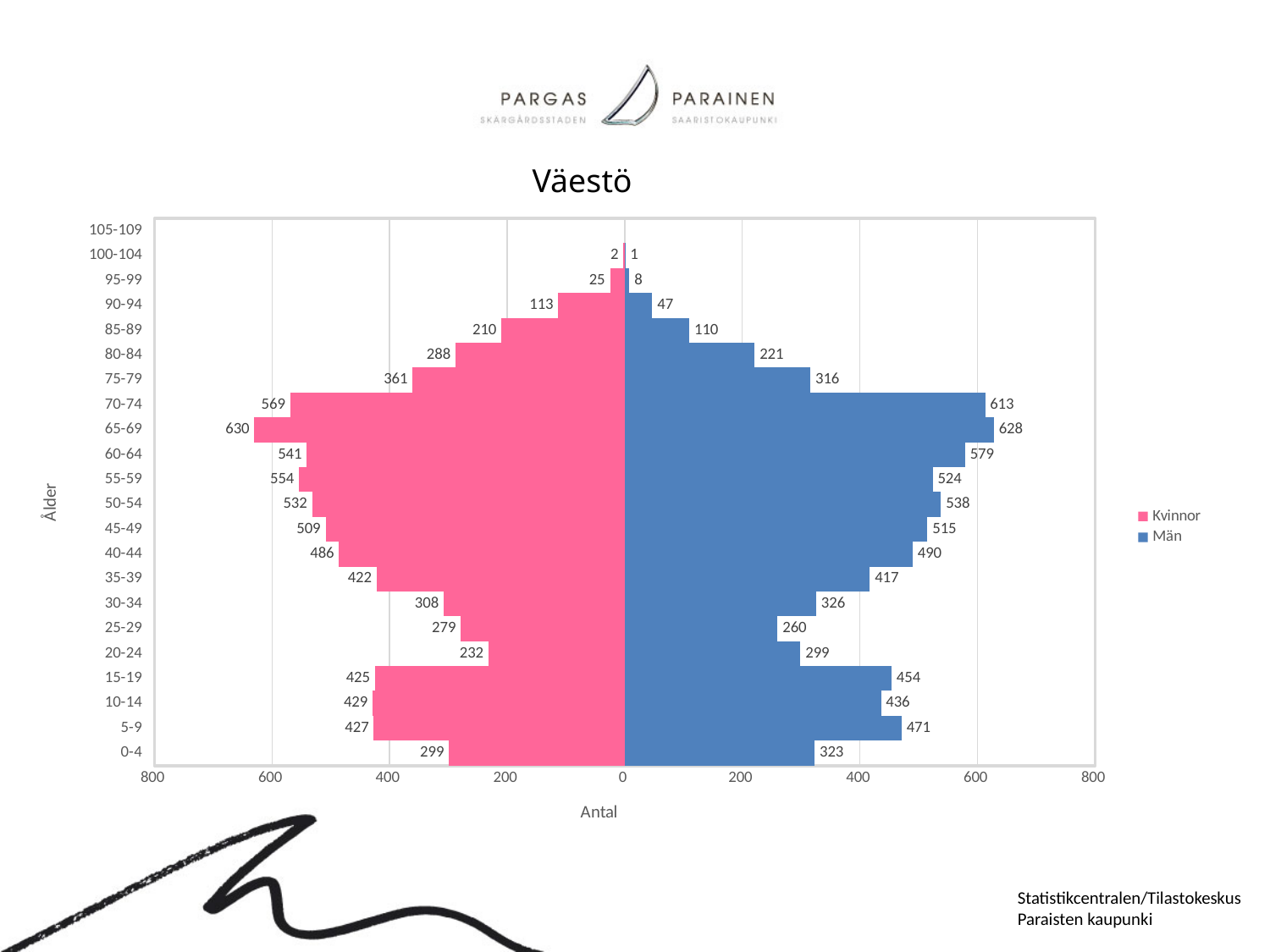
Which age group has the highest value for Kvinnor? 65-69 Which age group has the highest value for Män? 65-69 What is the value for Män in the 70-74 age group? 613 Which is larger in the 20-24 age group, Kvinnor or Män? Män How many series does the legend list? 2 What is the combined total of Kvinnor and Män in the 65-69 age group? 1258 What is the value for Kvinnor in the 20-24 age group? 232 What is the value for Kvinnor in the 65-69 age group? 630 What is the title of the chart? Väestö What is the difference between Män and Kvinnor in the 5-9 age group? 44 What kind of chart is shown on the slide? Bar chart How many age groups are shown on the vertical axis? 22